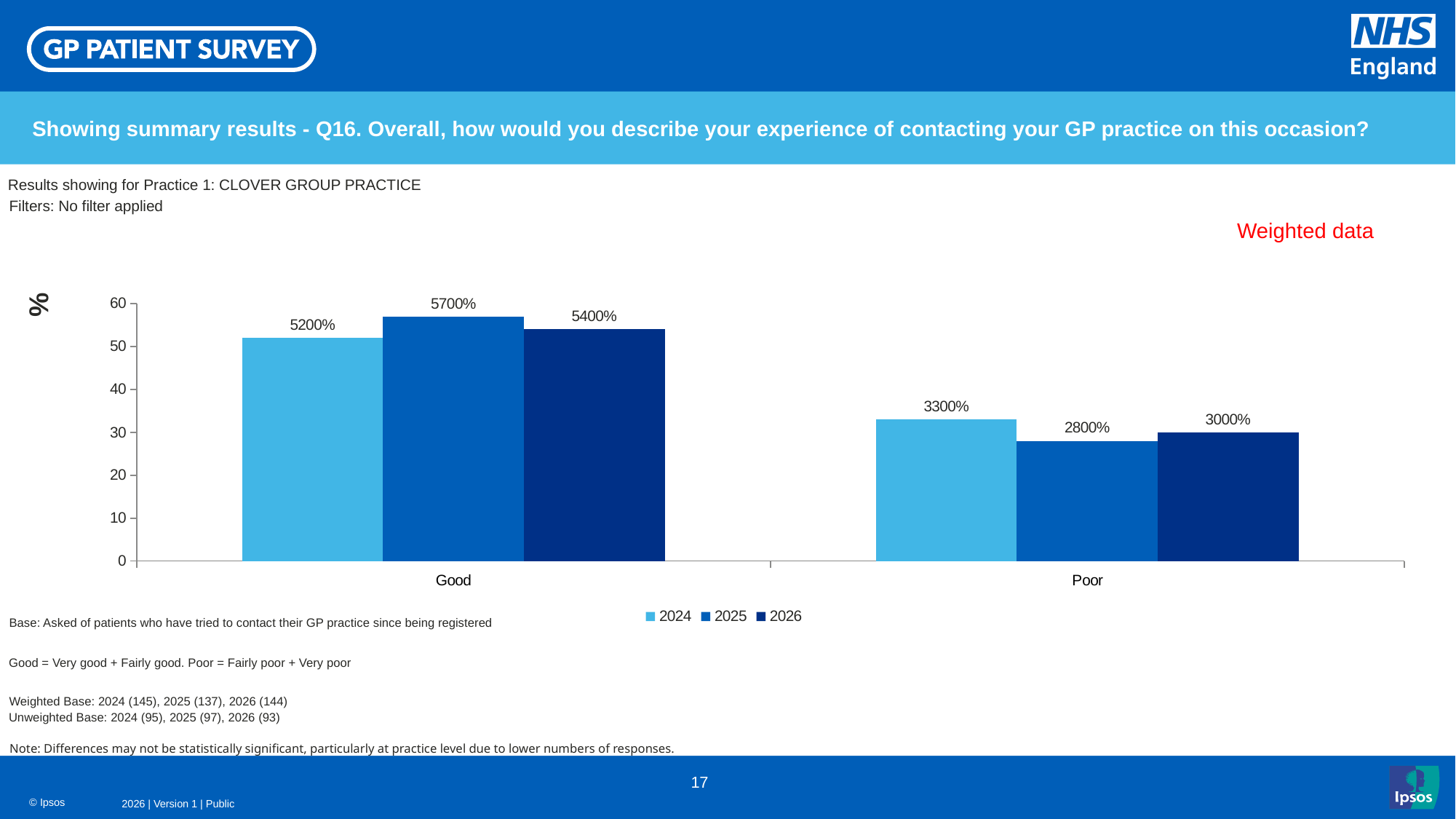
How many series does the legend list? 3 In the Good category, which bar is taller: 2024 or 2026? 2026 How many categories are shown on the x axis? 2 What is the data label for the 2024 bar in the Good category? 5200% What is the difference between the 2025 and 2024 data labels in the Good category? 500% What is the data label for the 2026 bar in the Poor category? 3000% What is the data label for the 2025 bar in the Good category? 5700% What kind of chart is shown on the slide? Bar chart Which year has the lowest bar in the Poor category? 2025 Which year has the highest bar in the Good category? 2025 What are the legend entries of the chart? 2024, 2025, 2026 What is the data label for the 2024 bar in the Poor category? 3300%